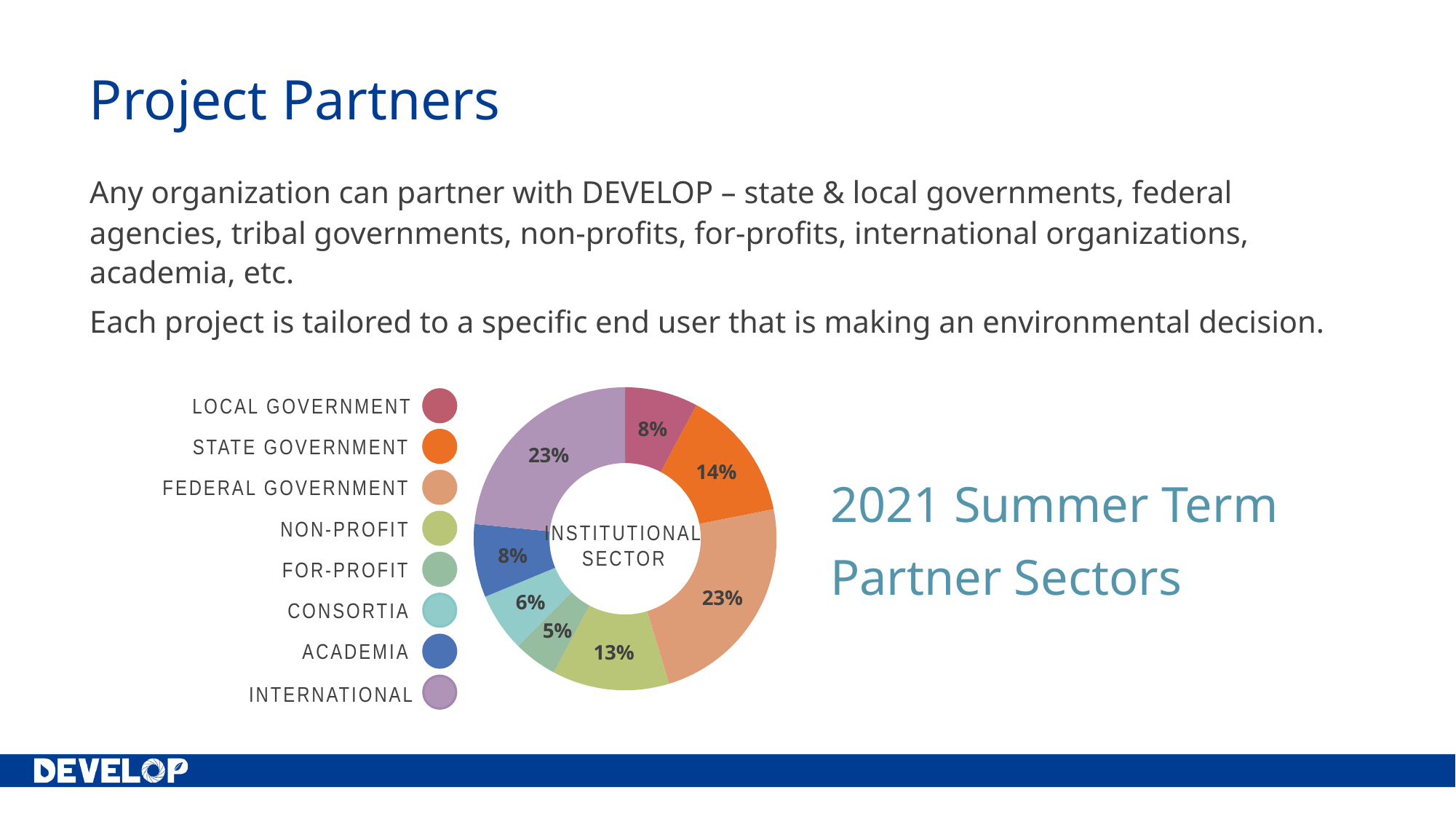
What is the combined share of Local Government and State Government? 22% What text appears in the centre of the donut chart? INSTITUTIONAL SECTOR What percentage is shown for Academia? 8% Which sector has the smallest share in the chart? For-Profit What percentage is shown for the Non-Profit sector? 13% What share of the donut chart is labelled for State Government? 14% What type of chart is used to show the partner sectors? Donut (pie) chart Which has a larger share, Consortia or For-Profit? Consortia How many sectors are listed in the chart legend? 8 What percentage of partners are from the Federal Government sector? 23% What is the difference in percentage points between the International and Consortia shares? 17 Which has a larger share, State Government or Non-Profit? State Government